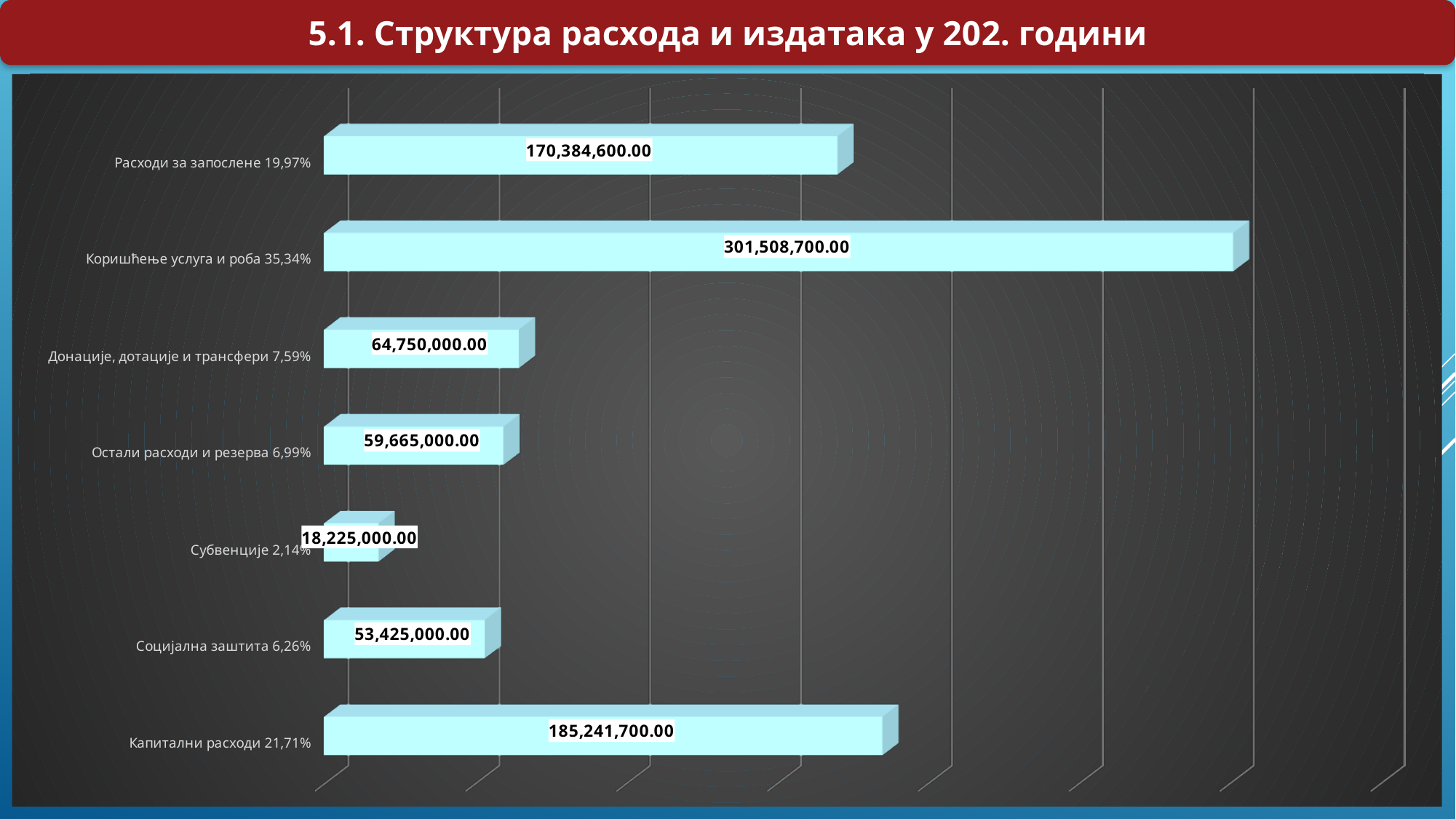
Which category has the lowest value? Субвенције What is the value for Расходи за запослене? 170,384,600.00 What is the value for Коришћење услуга и роба? 301,508,700.00 How many categories are shown in the chart? 7 What percentage share is shown in the label for Капитални расходи? 21,71% What is the difference between the values for Капитални расходи and Расходи за запослене? 14,857,100.00 What is the value for Субвенције? 18,225,000.00 What is the value for Капитални расходи? 185,241,700.00 Which category has the highest value? Коришћење услуга и роба What is the difference between the values for Коришћење услуга и роба and Расходи за запослене? 131,124,100.00 Which is larger, the value for Социјална заштита or the value for Остали расходи и резерва? Остали расходи и резерва What type of chart is shown on the slide? Bar chart